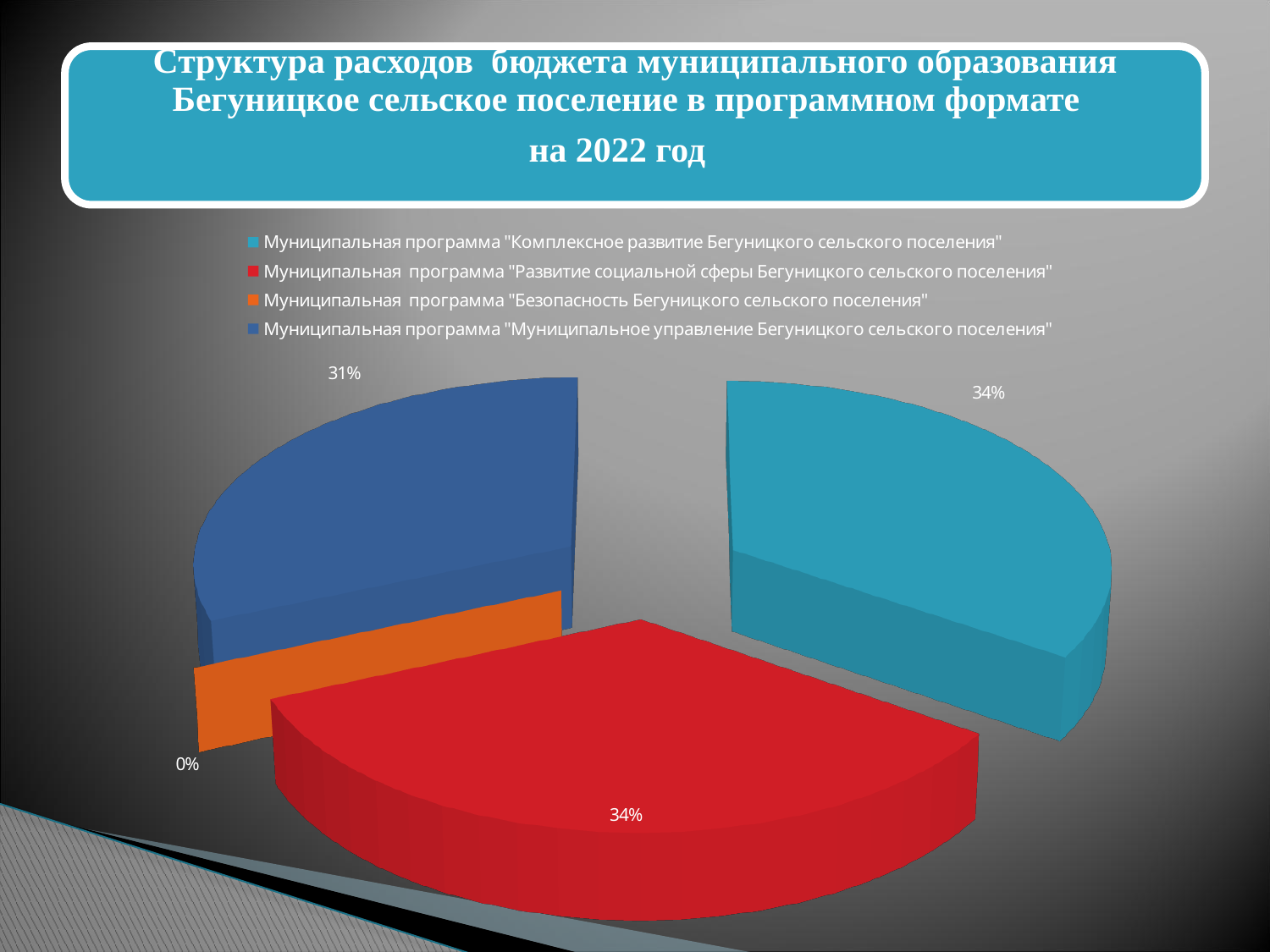
What is the difference between the share for "Муниципальное управление Бегуницкого сельского поселения" and the share for "Безопасность Бегуницкого сельского поселения"? 31% What share of the pie does the Муниципальная программа "Развитие социальной сферы Бегуницкого сельского поселения" slice have? 34% Which is larger: the share for "Комплексное развитие Бегуницкого сельского поселения" or the share for "Муниципальное управление Бегуницкого сельского поселения"? Комплексное развитие Бегуницкого сельского поселения For which year does the chart title say the budget expenditure structure is shown? 2022 What share of the pie does the Муниципальная программа "Комплексное развитие Бегуницкого сельского поселения" slice have? 34% Which program has the smallest share of the pie? Муниципальная программа "Безопасность Бегуницкого сельского поселения" How many categories does the legend of the pie chart list? 4 What is the difference between the share for "Развитие социальной сферы Бегуницкого сельского поселения" and the share for "Муниципальное управление Бегуницкого сельского поселения"? 3% What kind of chart is shown on the slide? pie chart What share of the pie does the Муниципальная программа "Безопасность Бегуницкого сельского поселения" slice have? 0% What colour is the slice for Муниципальная программа "Развитие социальной сферы Бегуницкого сельского поселения"? red